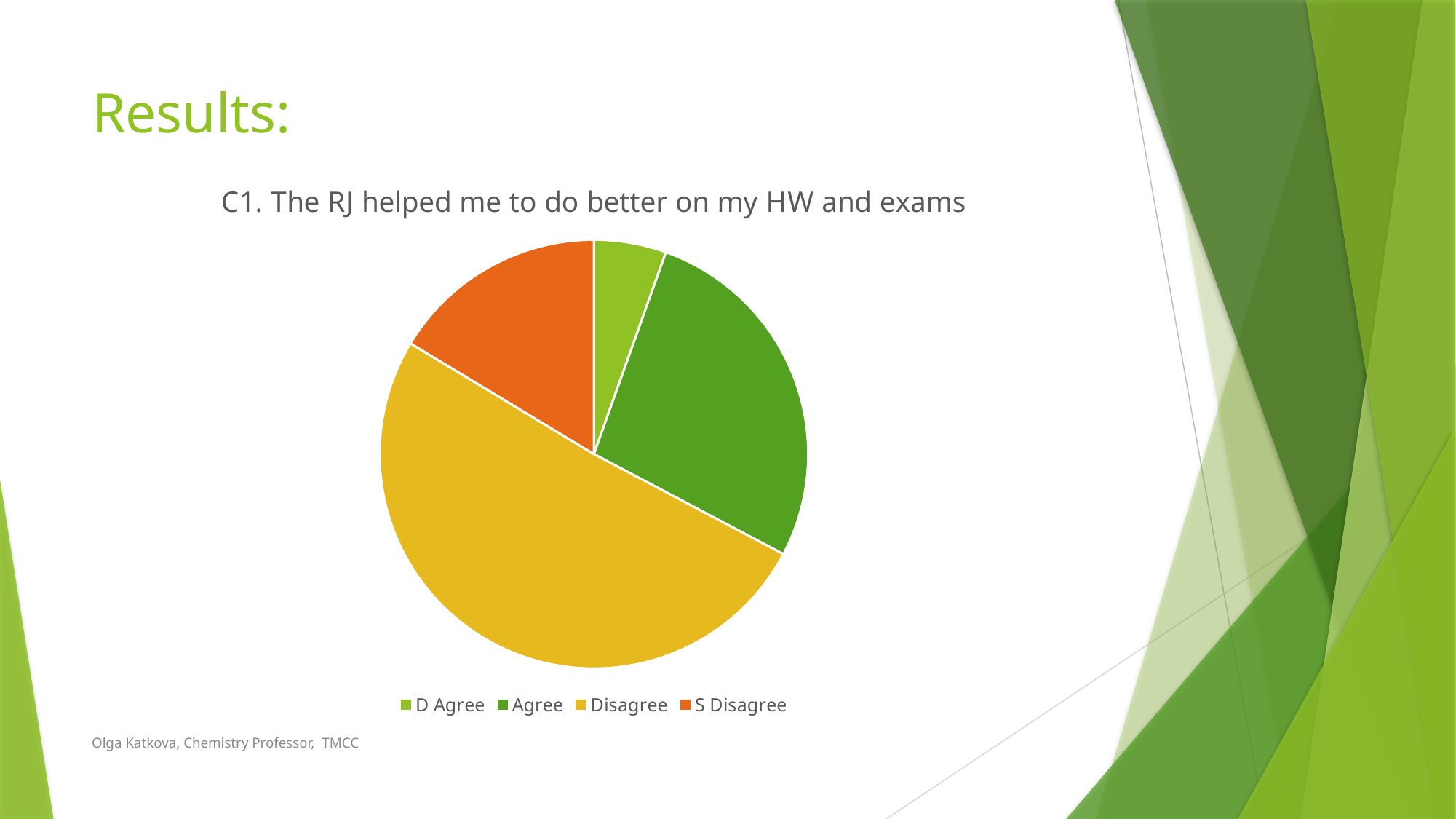
Which slice is larger, S Disagree or D Agree? S Disagree How many slices does the pie chart have? 4 Which category has the largest slice of the pie? Disagree Which category is shown in orange in the pie chart? S Disagree Which category has the smallest slice of the pie? D Agree How many entries does the legend list? 4 Which slice is larger, Disagree or Agree? Disagree Which slice is larger, Agree or S Disagree? Agree What kind of chart is shown on the slide? pie chart What is the title of the chart? C1. The RJ helped me to do better on my HW and exams